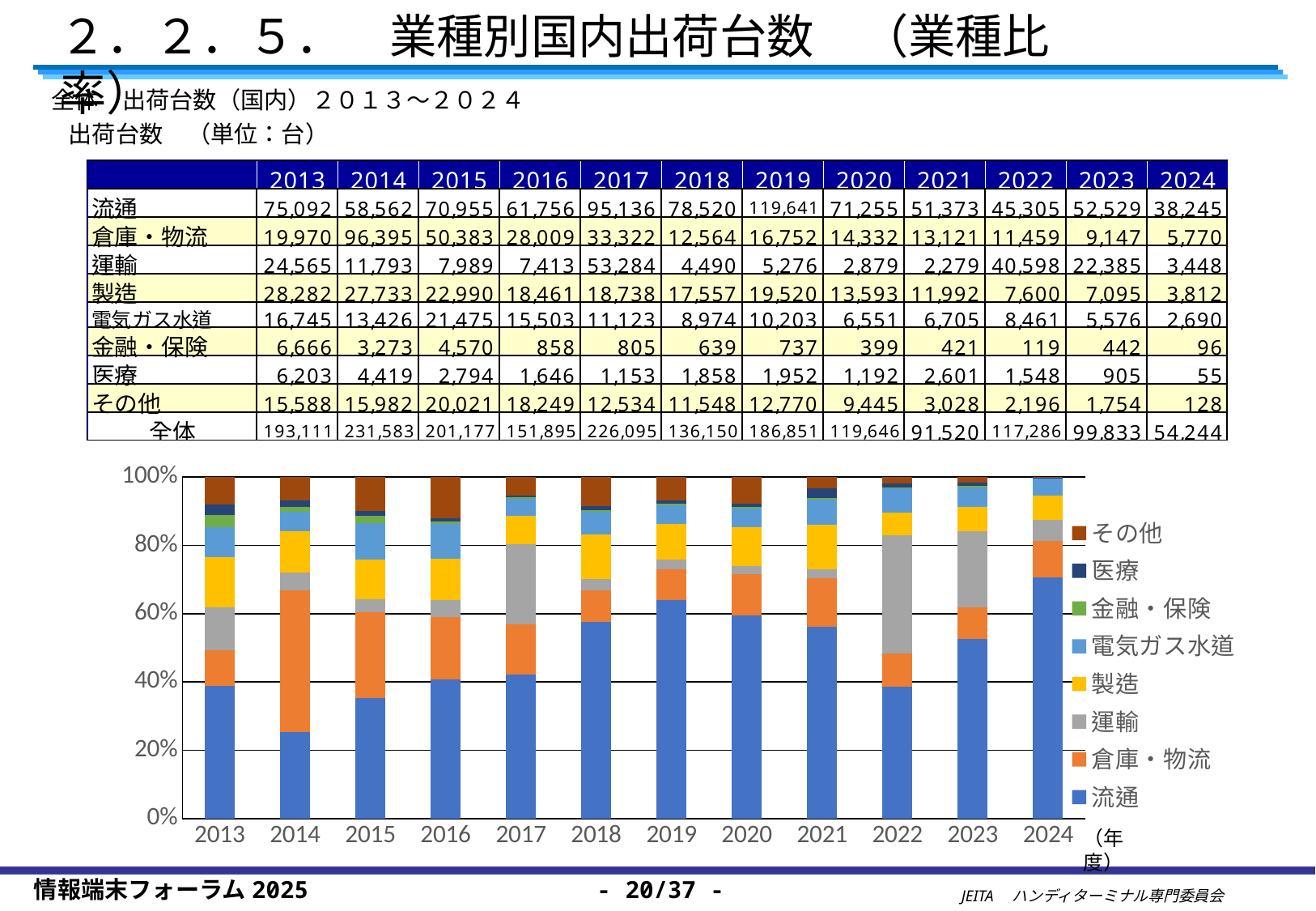
In the chart, is the share for 流通 in 2014 greater or less than 40%? less In the chart, is the share for 倉庫・物流 in 2014 greater or less than 20%? greater How many years are plotted along the x axis of the chart? 12 In the chart, does the share for 流通 rise or fall from 2017 to 2019? rise In the chart, is the share for 製造 in 2013 greater or less than 20%? less What kind of chart is shown below the table on the slide? 100% stacked bar chart In the chart, which year has the lowest share for 流通? 2014 In the chart, which year has the highest share for 流通? 2024 How many series does the chart's legend list? 8 In the chart, which is larger: the share for 倉庫・物流 in 2014 or in 2024? 2014 Which series is listed at the top of the chart's legend? その他